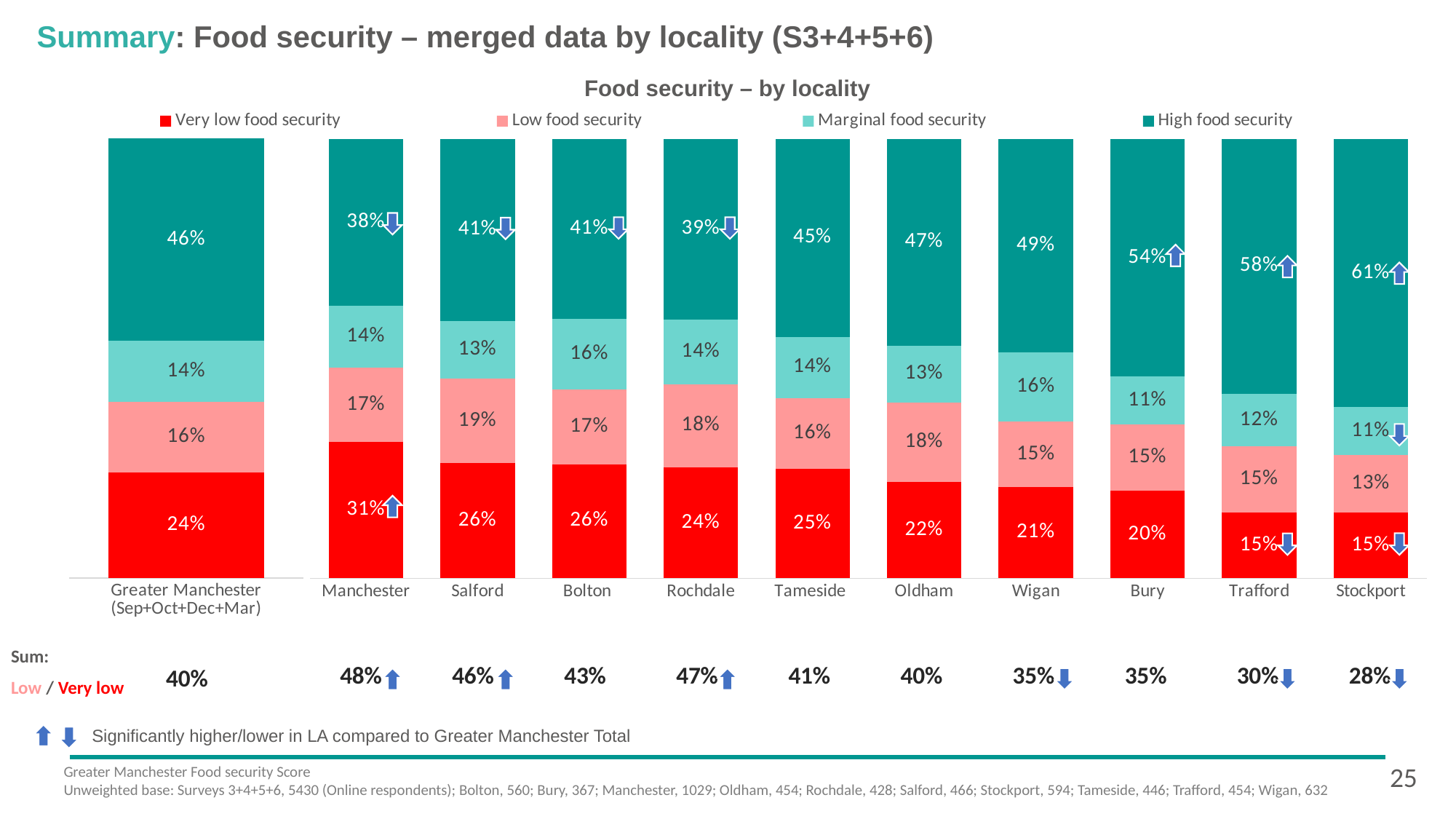
How many series does the legend list? 4 What kind of chart is shown? Stacked bar chart What is the value for Marginal food security in Bolton? 16% What is the value for Very low food security in Manchester? 31% Which is larger: the High food security value for Wigan or for Oldham? Wigan How many localities are shown on the x axis? 11 What is the value for Low food security in Salford? 19% Which locality has the highest value for High food security? Stockport What is the title of the chart? Food security – by locality What is the difference between the Very low food security values for Manchester and Bury? 11 percentage points What is the value for High food security in Stockport? 61% Which locality has the lowest value for Very low food security? Trafford and Stockport (15%)